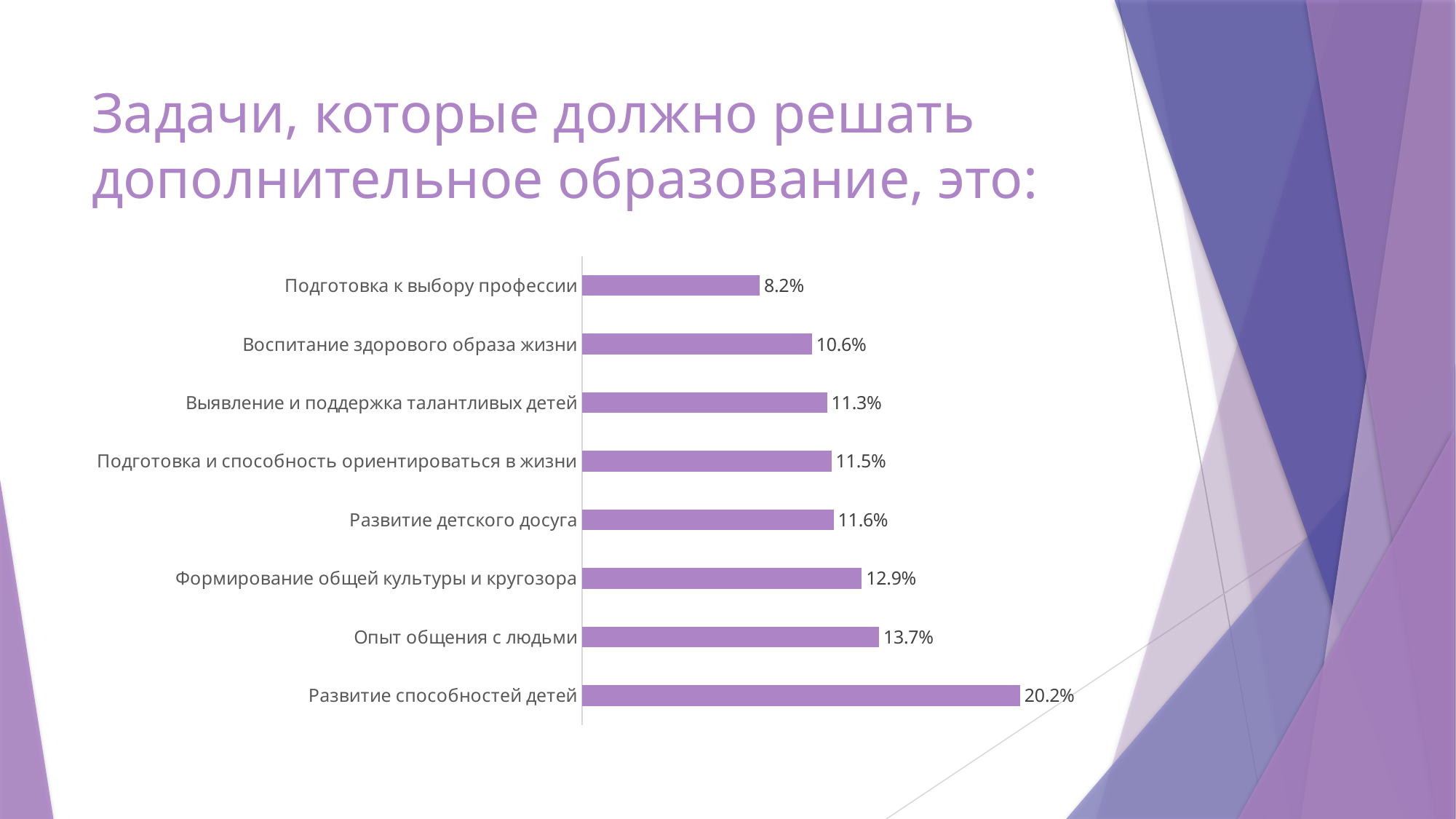
What is the value for Формирование общей культуры и кругозора? 12.9% What is the value for Воспитание здорового образа жизни? 10.6% How many categories are shown in the chart? 8 Which category has the highest value? Развитие способностей детей What is the value for Развитие способностей детей? 20.2% What is the title of the slide? Задачи, которые должно решать дополнительное образование, это: What is the value for Подготовка к выбору профессии? 8.2% Which is larger: Опыт общения с людьми or Развитие детского досуга? Опыт общения с людьми What is the difference between Воспитание здорового образа жизни and Подготовка к выбору профессии? 2.4% What kind of chart is shown on the slide? Bar chart Which category has the lowest value? Подготовка к выбору профессии What is the difference between Развитие способностей детей and Опыт общения с людьми? 6.5%